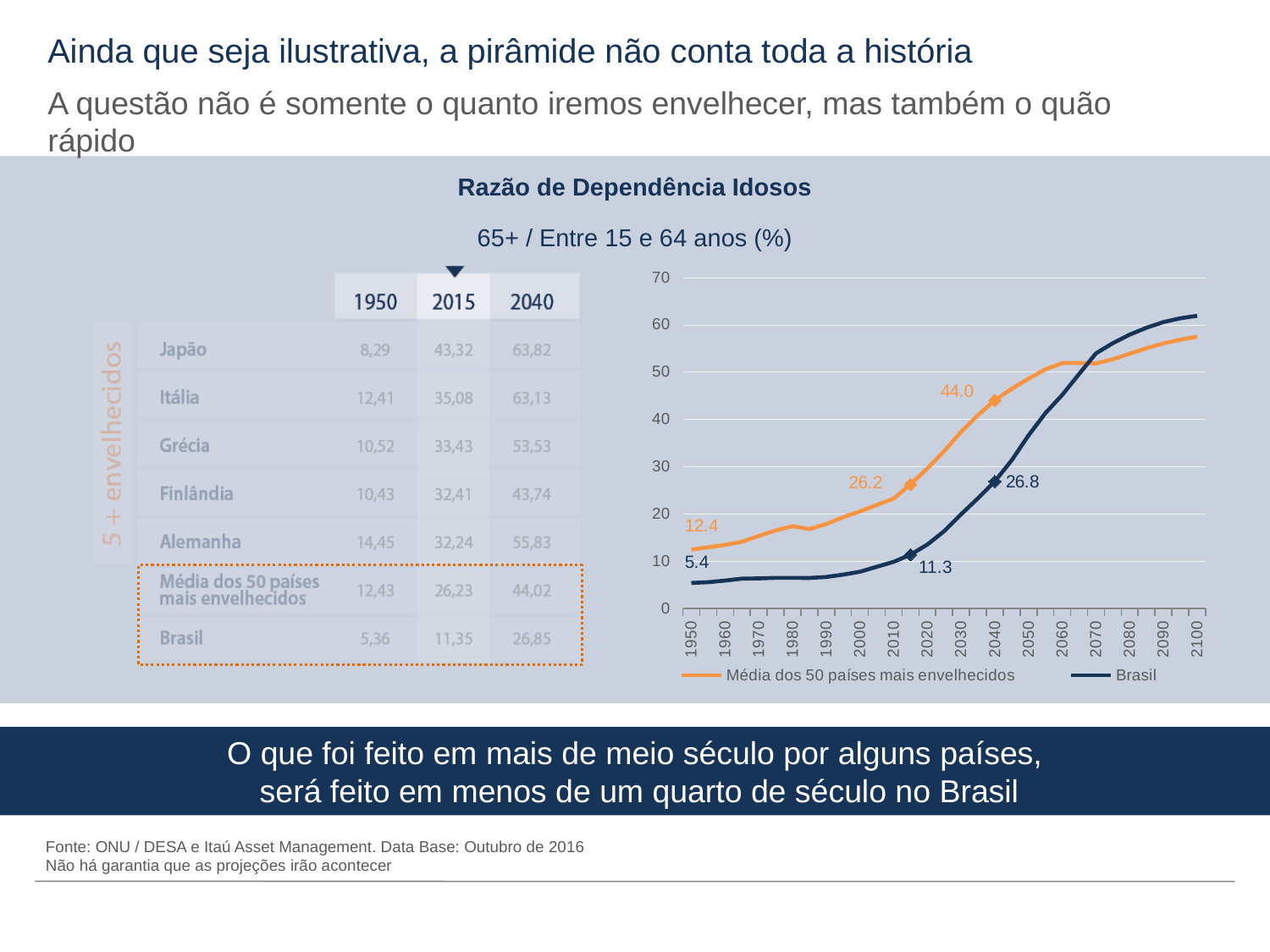
In 2015, which series has the larger value: Média dos 50 países mais envelhecidos or Brasil? Média dos 50 países mais envelhecidos What is the title of the chart? Razão de Dependência Idosos What is the value for Média dos 50 países mais envelhecidos in 1950? 12.4 How many series does the chart legend list? 2 What is the value for Brasil in 1950 on the line chart? 5.4 What is the value for Brasil in 2040? 26.8 What kind of chart is shown on the slide? Line chart Is the value for Brasil in 2100 greater or less than 60? greater What is the difference between the 2040 values of Média dos 50 países mais envelhecidos and Brasil? 17.2 By how much does the Brasil value increase from 1950 to 2040? 21.4 Does the Brasil series rise or fall from 1950 to 2100? Rise What is the value for Média dos 50 países mais envelhecidos in 2040? 44.0